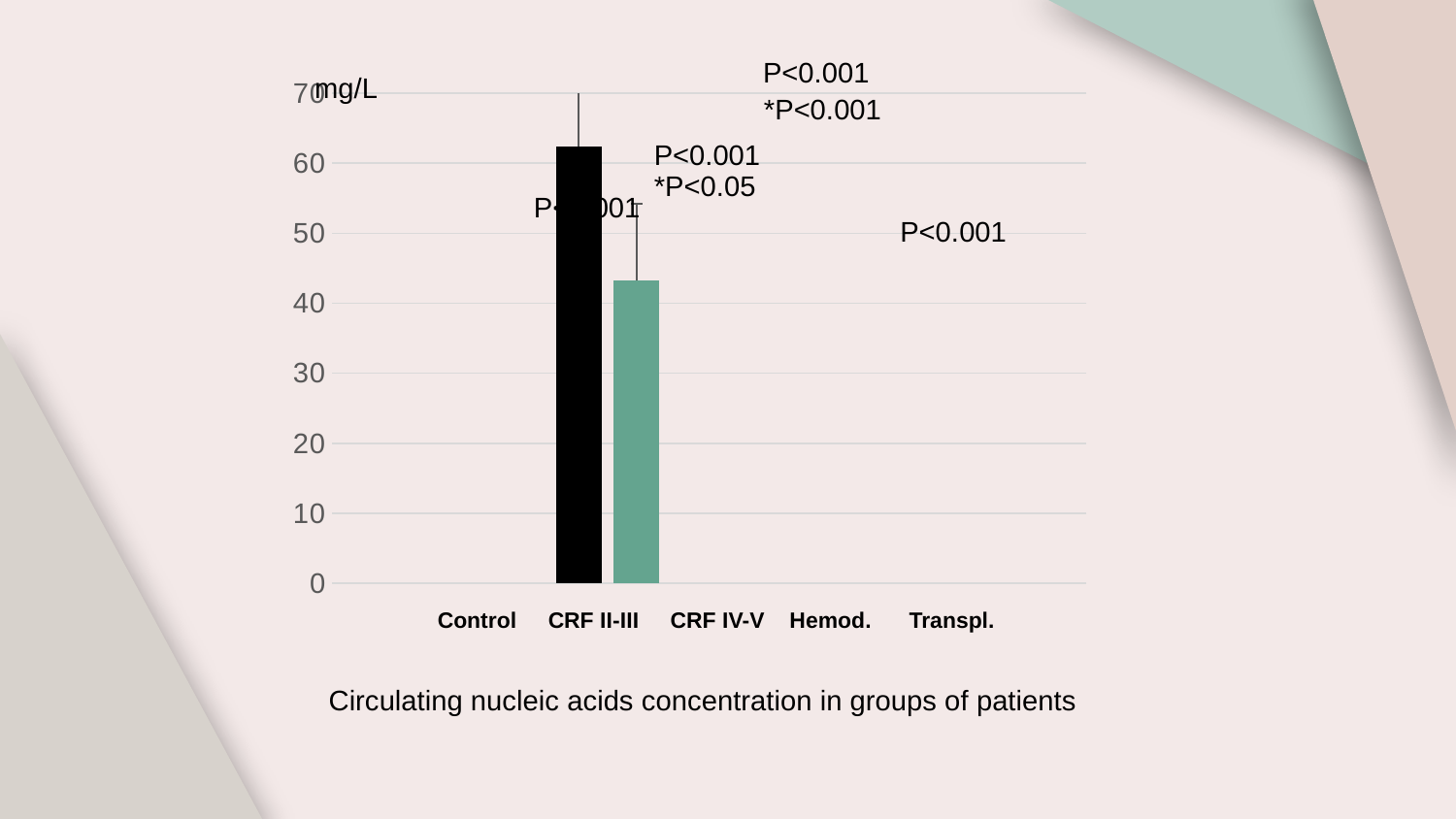
Is the value of the black bar greater or less than 50? greater How many patient groups are labelled along the x axis of the chart? 5 Which bar is taller in the chart, the black bar or the green bar? the black bar Which x-axis category label appears last (rightmost) in the chart? Transpl. What kind of chart is shown on the slide? bar chart How many bars are actually drawn in the chart? 2 What unit is shown at the top of the y axis? mg/L What is the highest value shown on the y axis? 70 Is the value of the green bar greater or less than 50? less Which x-axis category label appears first (leftmost) in the chart? Control What is the caption below the chart? Circulating nucleic acids concentration in groups of patients Is the value of the green bar greater or less than 30? greater